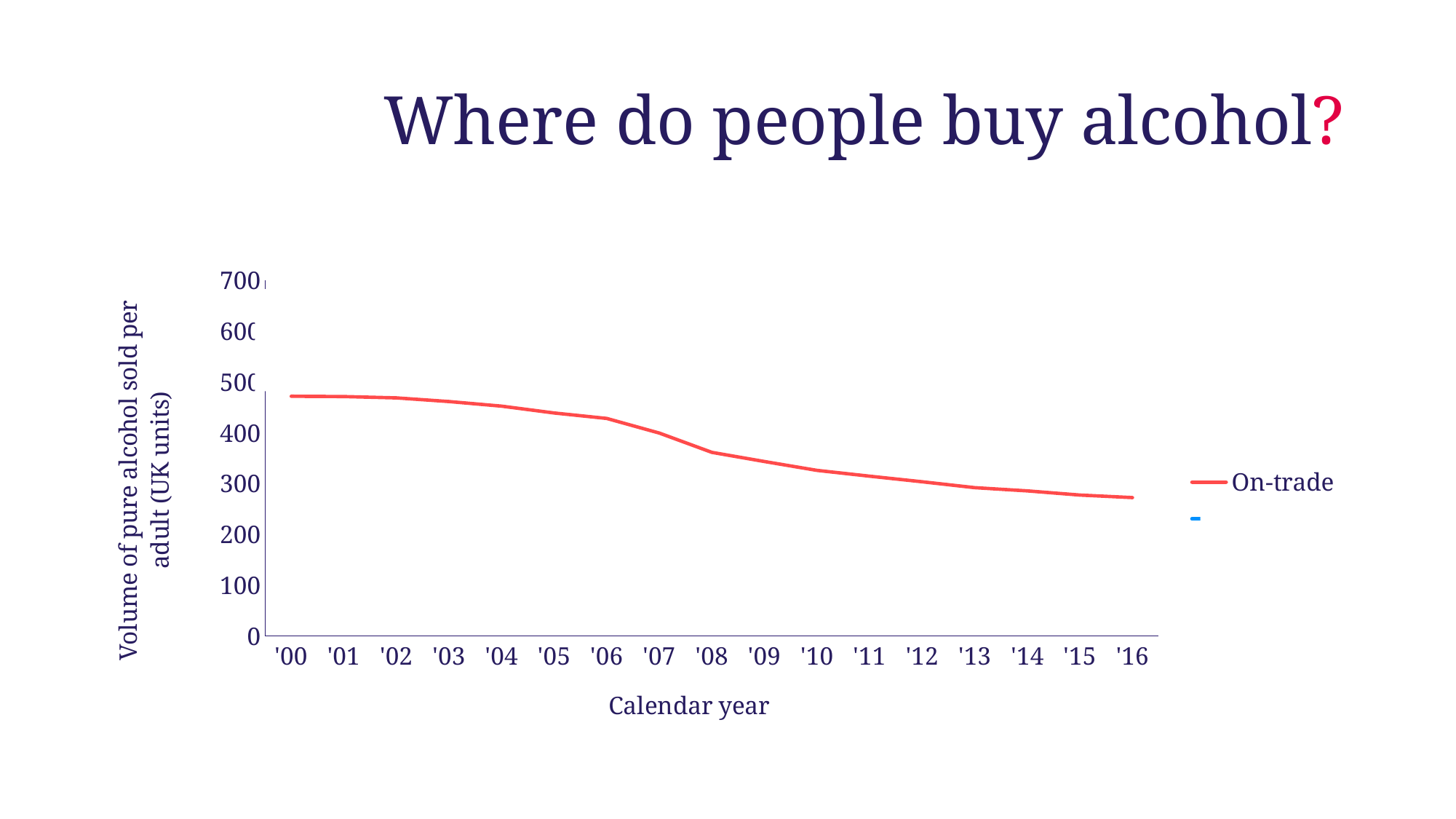
What kind of chart is shown on the slide? line chart How many years are plotted along the x axis? 17 What is the label of the x axis? Calendar year What is the title of the slide? Where do people buy alcohol? In which year is the On-trade value lowest? '16 Is the On-trade value for '06 greater or less than 400? greater Does the On-trade line rise or fall from '00 to '16? fall Is the On-trade value for '08 greater or less than 400? less Is the On-trade value for '00 greater or less than 500? less In which year is the On-trade value highest? '00 Which year has the larger On-trade value, '04 or '10? '04